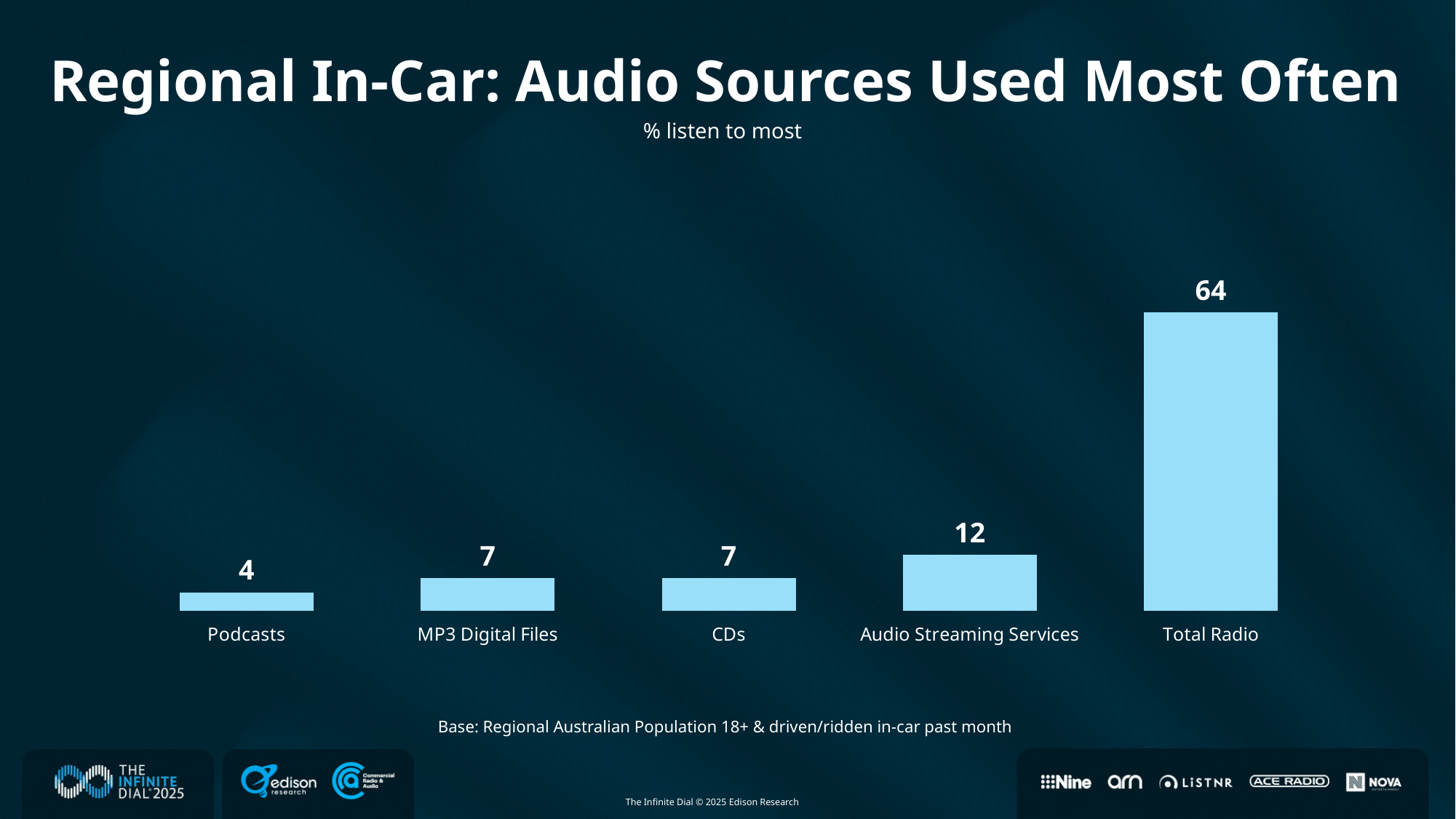
What is the difference between the values for MP3 Digital Files and Podcasts? 3 What is the difference between the values for Total Radio and Audio Streaming Services? 52 What is the value for CDs? 7 Which category has the lowest value? Podcasts What is the title of the chart? Regional In-Car: Audio Sources Used Most Often What kind of chart is shown on the slide? Bar chart What is the value for Audio Streaming Services? 12 What is the value for Total Radio? 64 Which is larger, the value for Audio Streaming Services or the value for CDs? Audio Streaming Services What is the value for Podcasts? 4 How many categories are shown in the chart? 5 Which category has the highest value? Total Radio